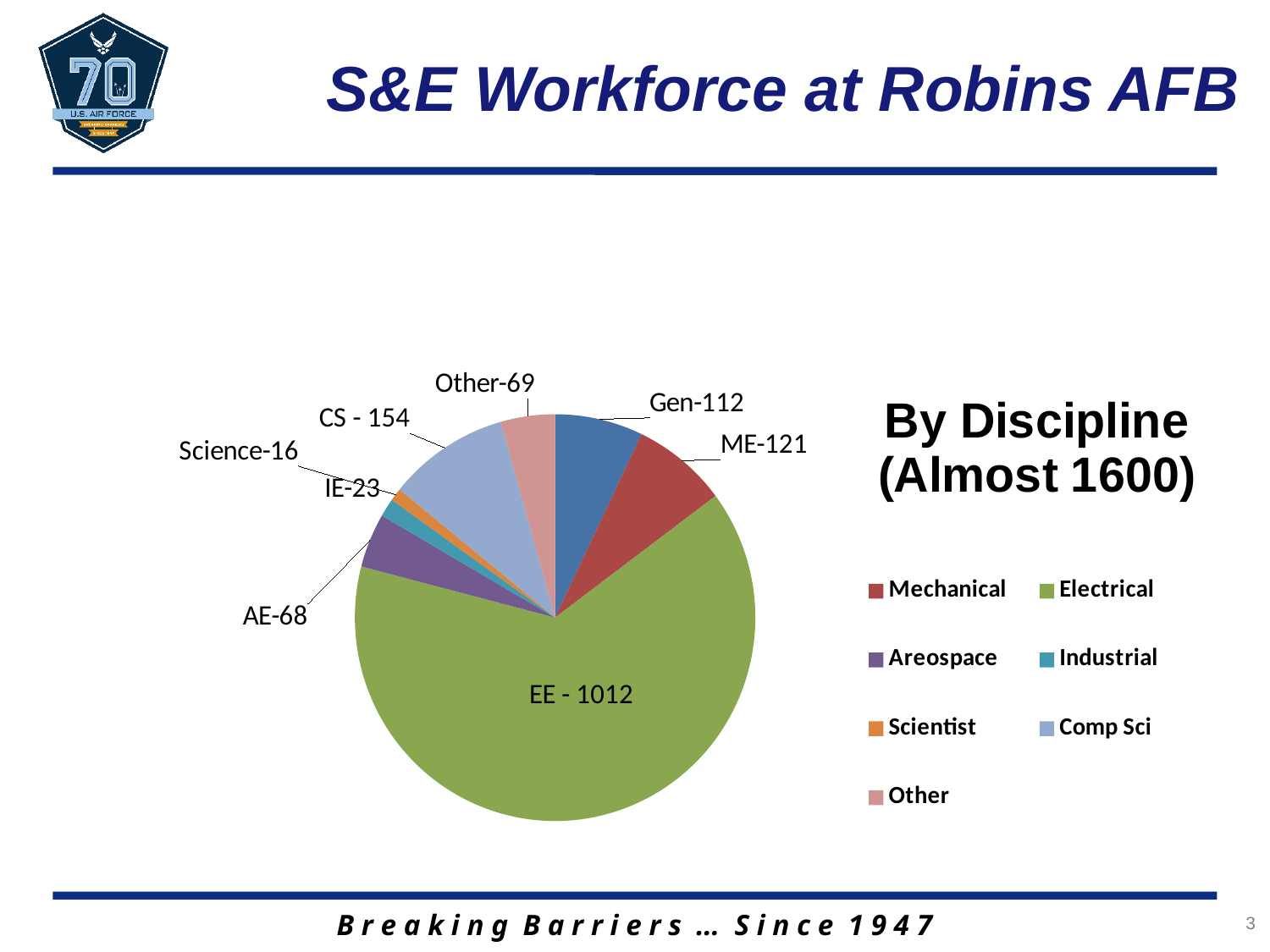
What is the difference between the ME value and the Gen value? 9 What is the value shown for the Science slice? 16 How many entries does the legend list? 7 What is the title shown next to the pie chart? By Discipline (Almost 1600) Which is larger, the AE value or the Other value? Other Which slice of the pie is the largest? EE - 1012 How many slices does the pie chart have? 8 What is the value shown for the CS slice? 154 What is the value shown for the EE slice? 1012 What is the difference between the CS value and the Other value? 85 What kind of chart is shown on the slide? pie chart Which slice of the pie is the smallest? Science-16